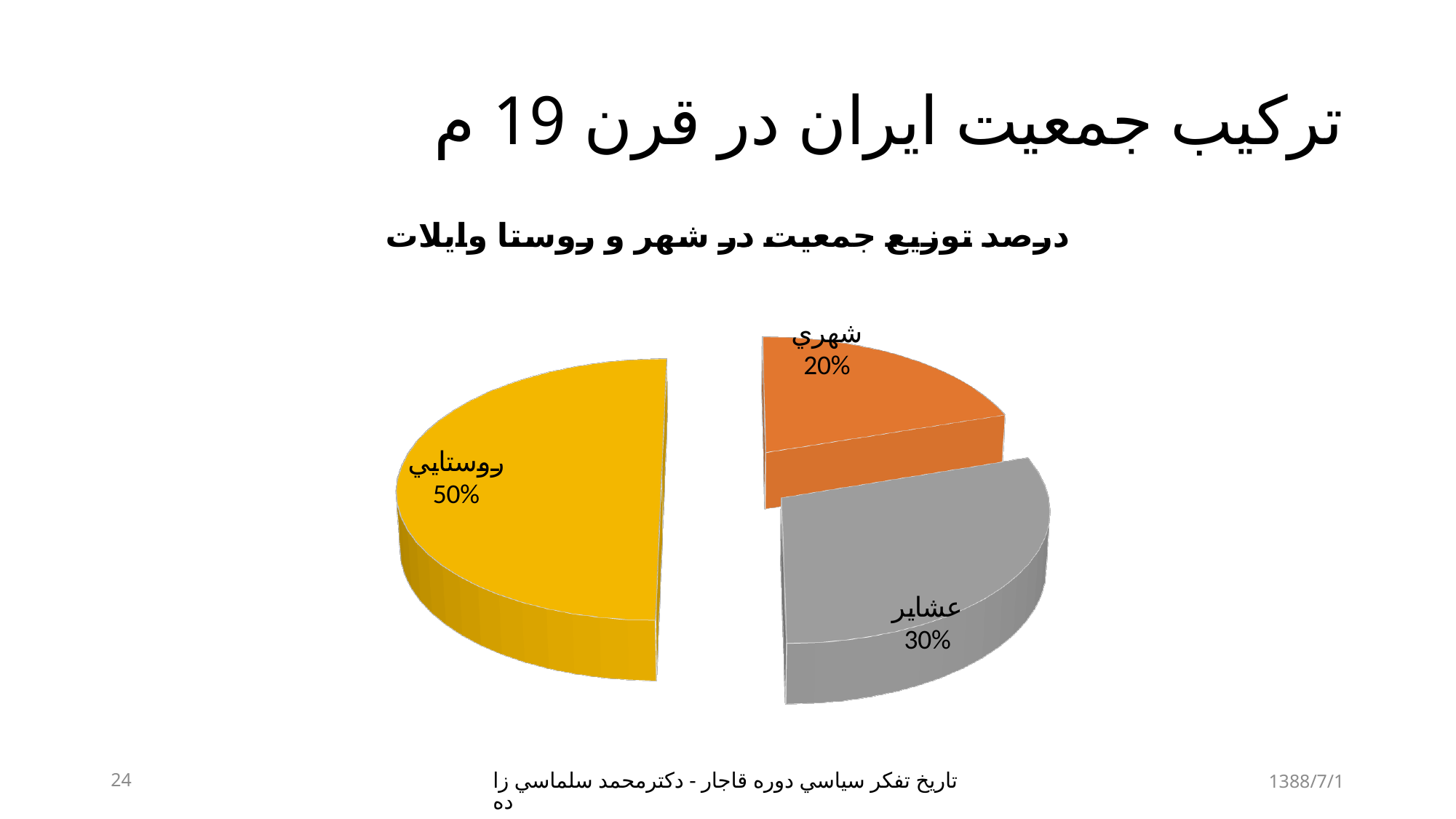
How many slices does the pie chart have? 3 Which category has the largest slice of the pie? روستايي Which category has the smallest slice of the pie? شهري What share of the pie does the روستايي slice represent? 50% What is the title of the chart? درصد توزيع جمعيت در شهر و روستا و ايلات What share of the pie does the عشاير slice represent? 30% What is the difference in percentage points between the عشاير and شهري slices? 10 What kind of chart is shown on the slide? pie chart What colour is the روستايي slice? yellow What is the difference in percentage points between the روستايي and شهري slices? 30 What share of the pie does the شهري slice represent? 20% Which is larger, the عشاير slice or the شهري slice? عشاير